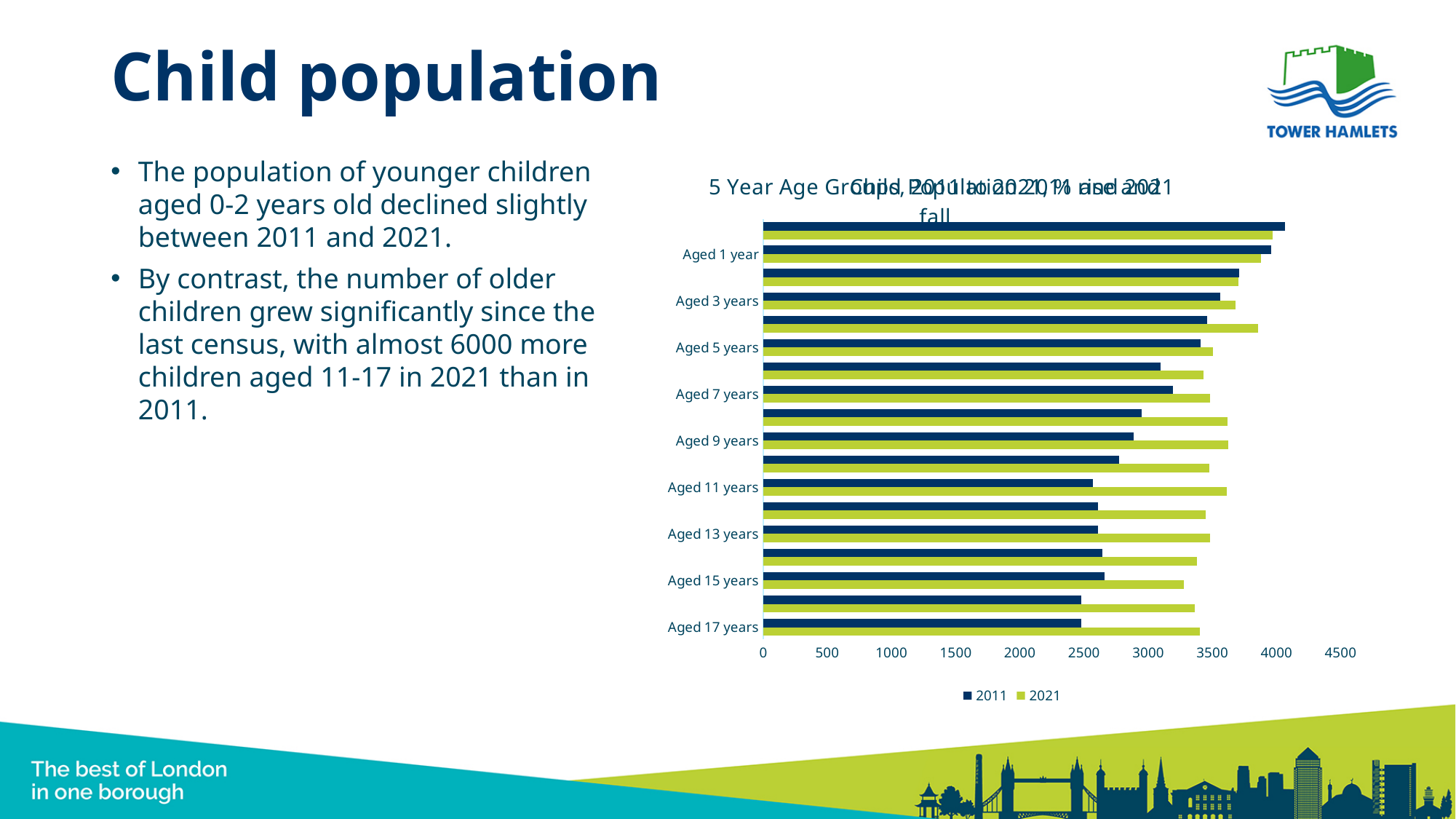
Which two years are listed in the chart legend? 2011 and 2021 How many series does the chart legend list? 2 How many age groups are labelled on the vertical axis of the chart? 9 For Aged 11 years, which series has the larger value, 2011 or 2021? 2021 Is the 2021 value for Aged 11 years greater or less than 3000? greater Is the 2011 value for Aged 13 years greater or less than 3000? less Is the 2011 value for Aged 1 year greater or less than 3500? greater What kind of chart is shown on the slide? bar chart Which colour represents the 2021 series in the chart? light green Do the 2011 values generally rise or fall going from Aged 1 year down to Aged 17 years? fall Which labelled age group has the highest 2011 value? Aged 1 year